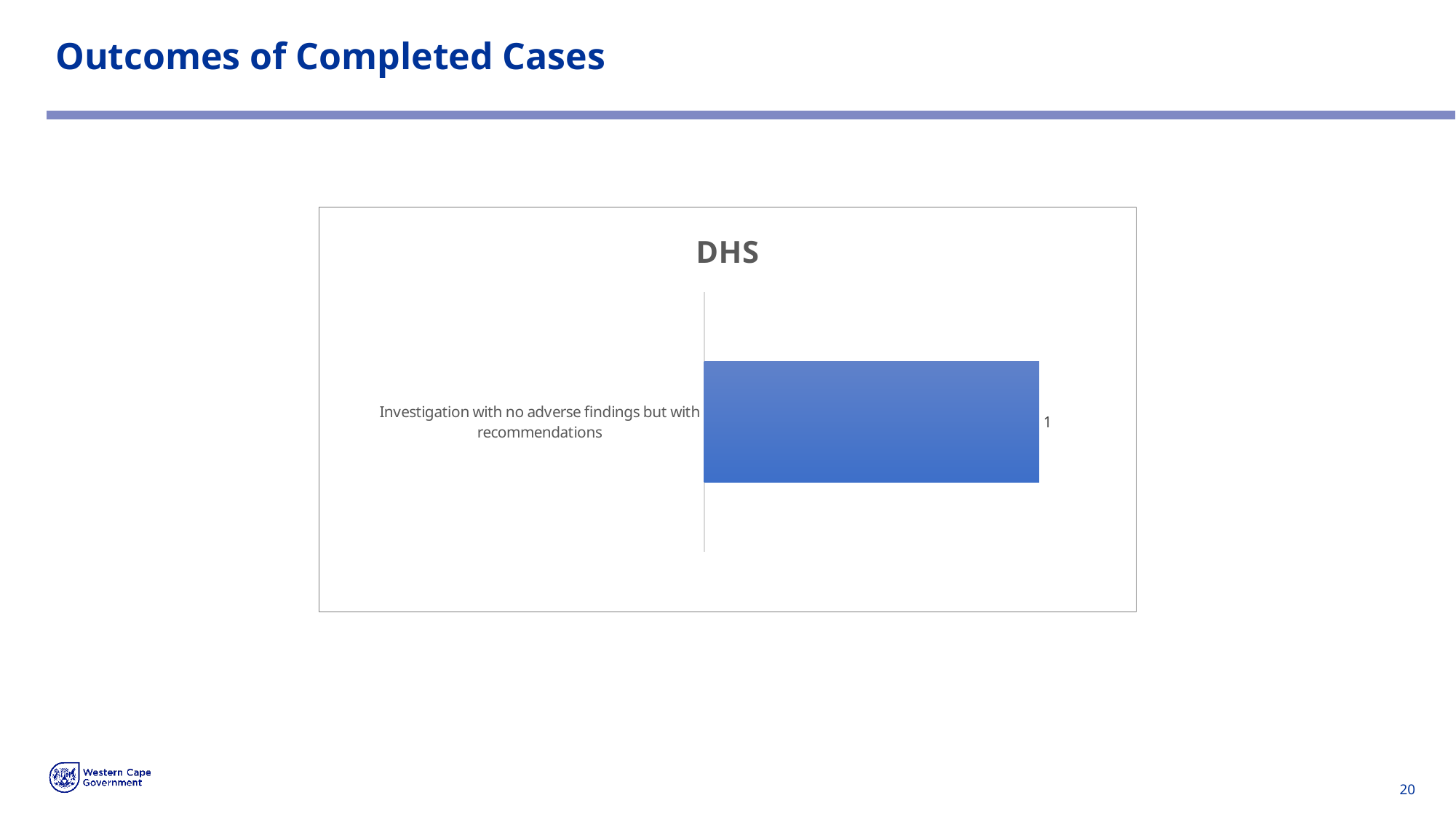
How many categories are plotted in the DHS chart? 1 What is the title of the chart on the slide? DHS What is the value for 'Investigation with no adverse findings but with recommendations' in the DHS chart? 1 Which category has the highest value in the DHS chart? Investigation with no adverse findings but with recommendations What is the label of the only category in the DHS chart? Investigation with no adverse findings but with recommendations What kind of chart is shown on the slide? bar chart